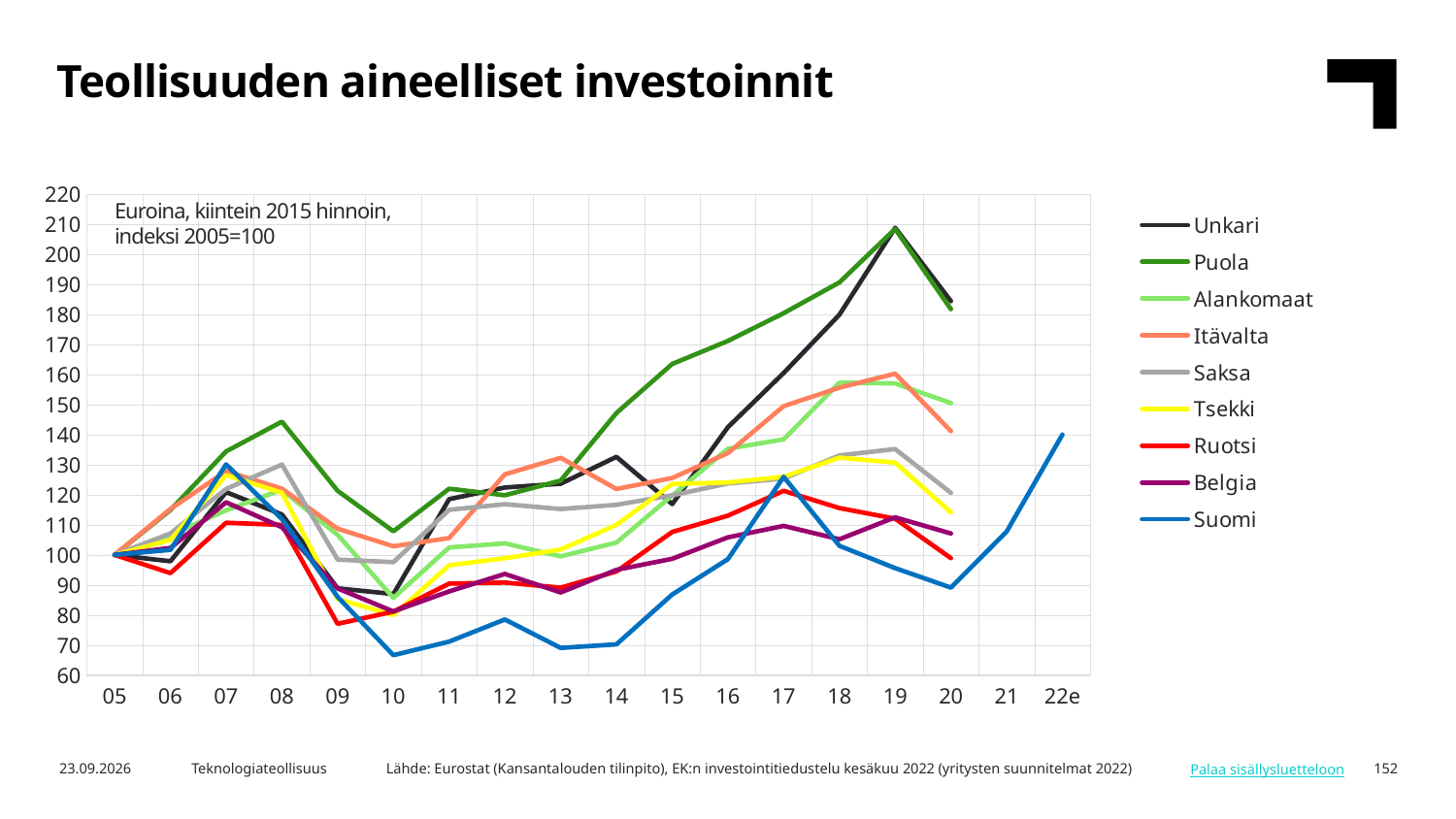
Which series is the only one plotted through to 22e? Suomi Which series has the lowest value in 2020? Suomi Is the value for Suomi in 2010 greater or less than 70? less Which series has the highest value in 2017? Puola Is the value for Itävalta in 2019 greater or less than 150? greater Is the value for Puola in 2019 greater or less than 200? greater Which series has the lowest value in 2010? Suomi How many year labels are shown on the x axis? 18 What kind of chart is shown on the slide? line chart Which is larger in 2013, the value for Suomi or the value for Ruotsi? Ruotsi Does the value for Suomi rise or fall from 2020 to 22e? rise How many series does the legend list? 9